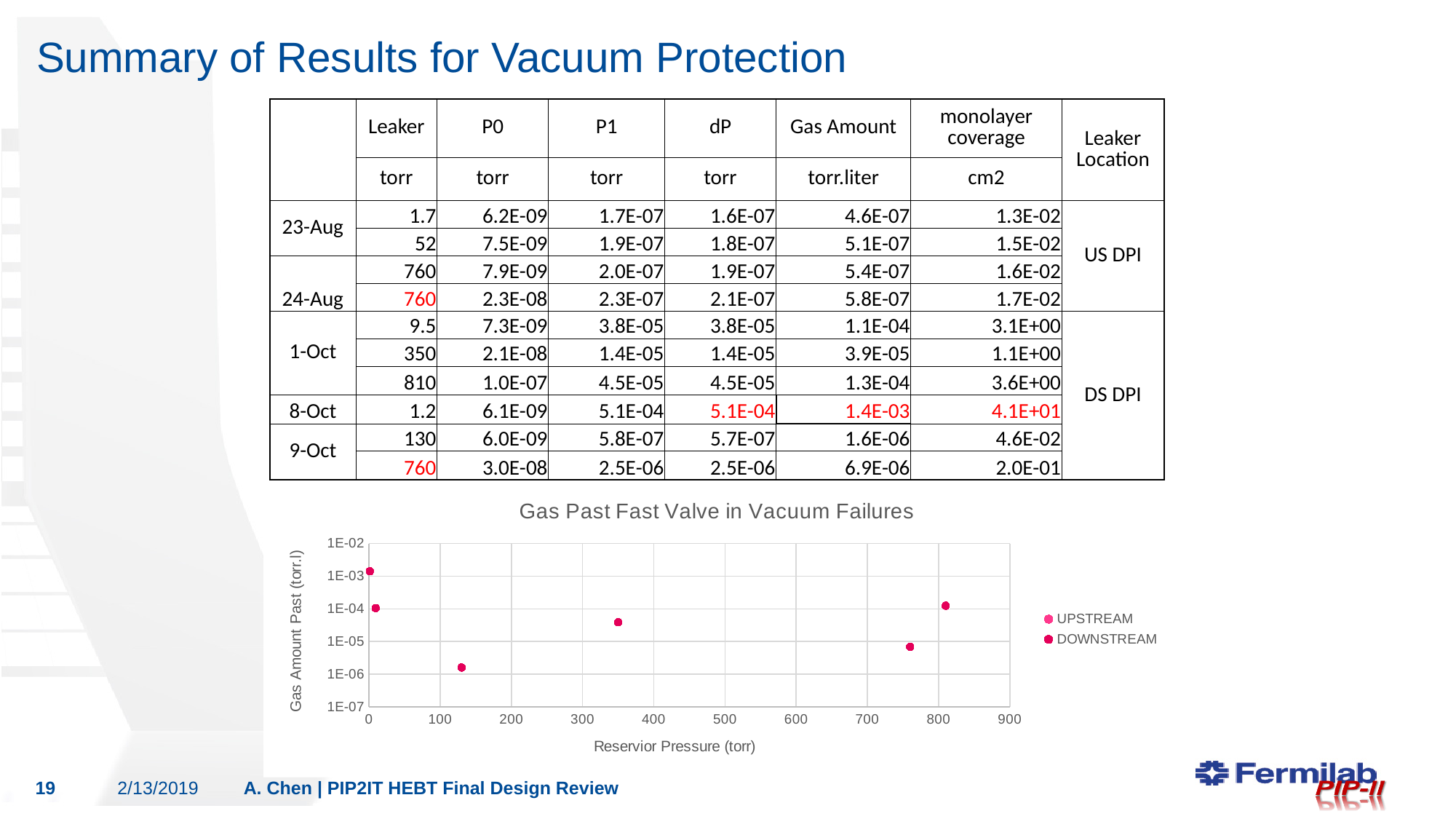
Which has the larger gas amount past: the point at about 810 torr or the point at about 130 torr? the point at about 810 torr Is the gas amount past for the point at about 130 torr reservoir pressure greater or less than 1E-05? less What are the two series named in the chart's legend? UPSTREAM and DOWNSTREAM What is the lowest value shown on the chart's y axis? 1E-07 Is the gas amount past for the point at about 350 torr reservoir pressure greater or less than 1E-05? greater What kind of chart is shown on the slide? scatter chart How many series does the chart's legend list? 2 Which has the larger gas amount past: the point at about 350 torr or the point at about 760 torr? the point at about 350 torr What is the title of the chart? Gas Past Fast Valve in Vacuum Failures Is the gas amount past for the point at about 760 torr reservoir pressure greater or less than 1E-04? less